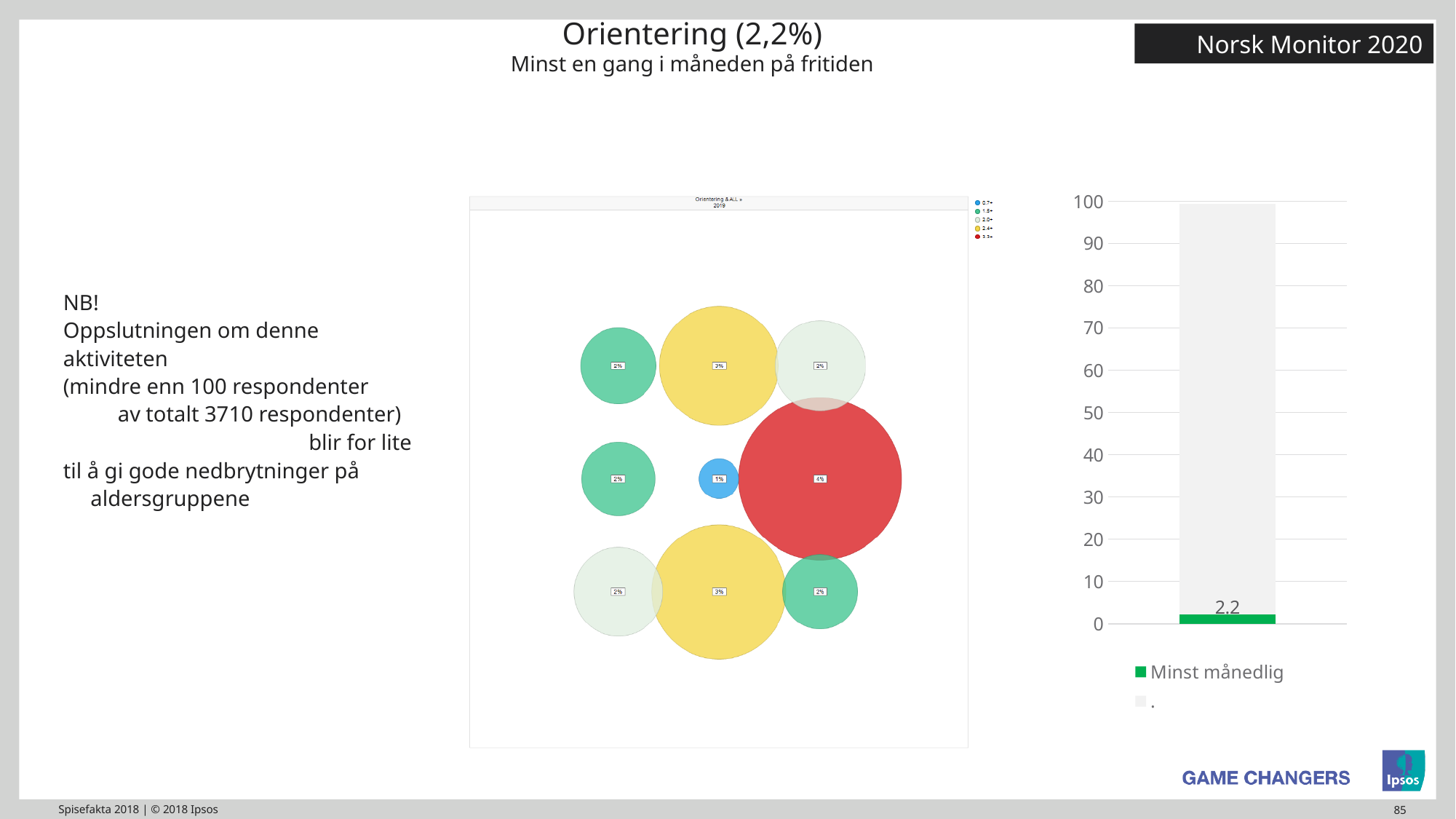
In the bar chart on the right, what colour is the 'Minst månedlig' segment? green In the bubble chart in the centre of the slide, what value is labelled on the red bubble? 4% How many bars are plotted in the bar chart on the right? 1 In the bar chart on the right, is the value for 'Minst månedlig' greater or less than 10? less In the bubble chart in the centre of the slide, what is the highest value labelled on any bubble? 4% In the bubble chart in the centre of the slide, what value is labelled on the blue bubble? 1% In the bubble chart in the centre of the slide, what is the lowest value labelled on any bubble? 1% In the bar chart on the right, what is the value for 'Minst månedlig'? 2.2 How many entries does the legend of the bar chart on the right list? 2 What kind of chart is shown on the right side of the slide? bar chart How many bubbles are shown in the bubble chart in the centre of the slide? 9 What is the highest value shown on the vertical axis of the bar chart on the right? 100